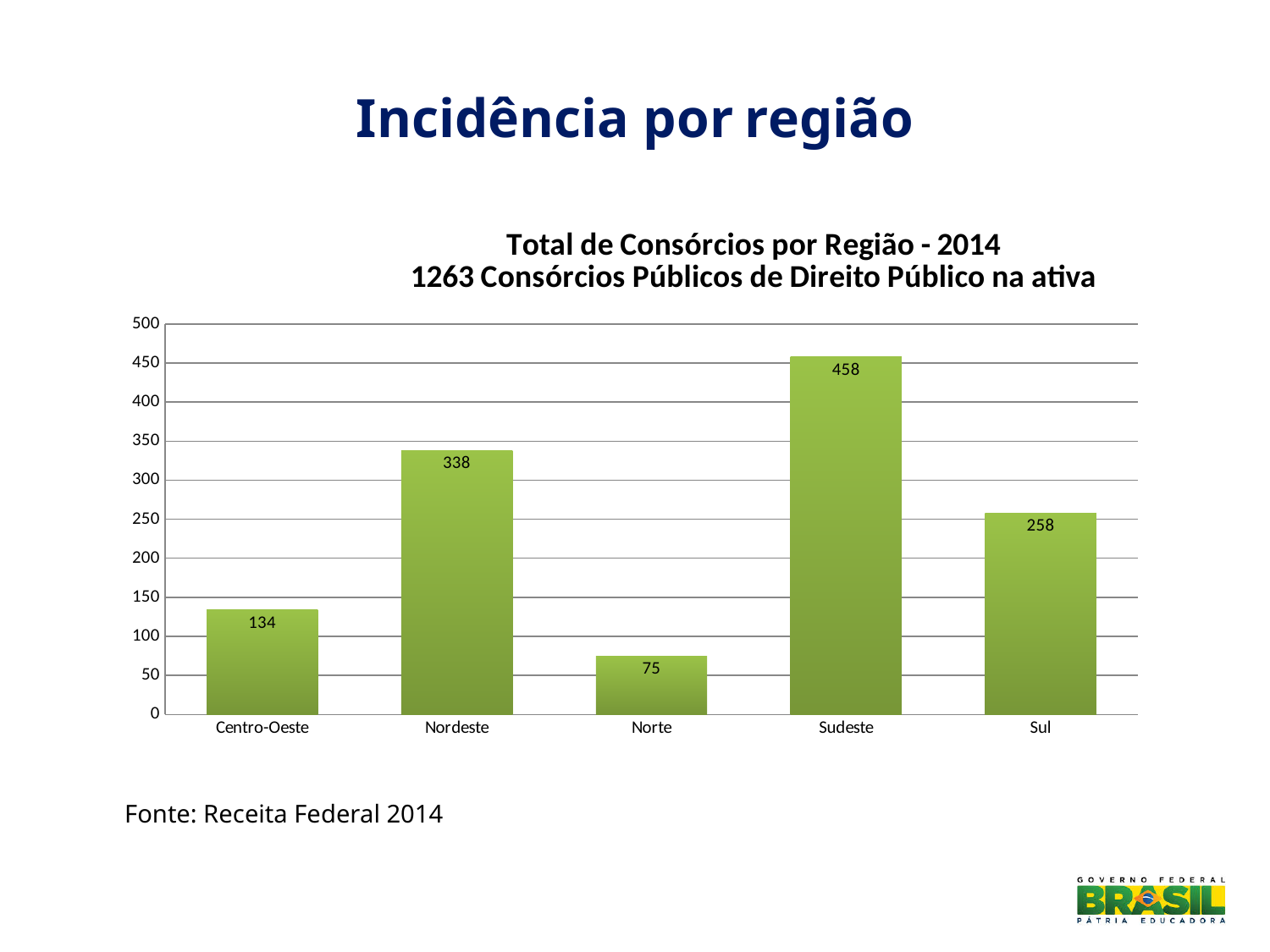
What is the title of the chart? Total de Consórcios por Região - 2014 1263 Consórcios Públicos de Direito Público na ativa What is the value for Sudeste? 458 Is the value for Sul greater or less than 300? less How many regions are shown on the chart? 5 Which region has the lowest value? Norte What is the difference between the values for Sudeste and Nordeste? 120 What is the difference between the values for Sul and Centro-Oeste? 124 What is the value for Norte? 75 What kind of chart is shown on the slide? bar chart Which is larger, the value for Nordeste or the value for Sul? Nordeste Which region has the highest value? Sudeste What is the value for Centro-Oeste? 134